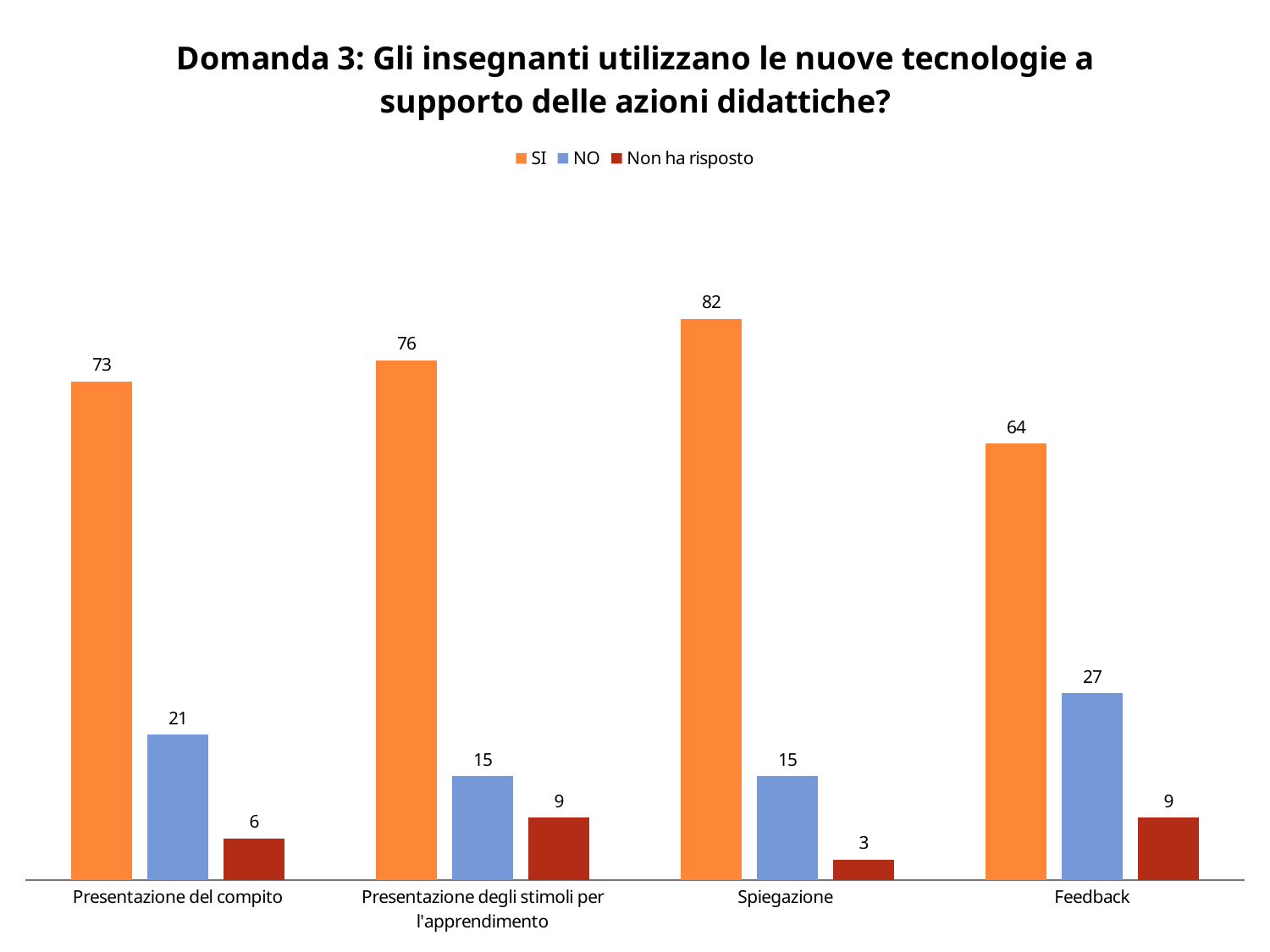
Which colour represents the NO series? Blue What is the NO value for Feedback? 27 Which category has the highest SI value? Spiegazione What is the SI value for Spiegazione? 82 How many categories are shown on the x axis? 4 What is the total of the three values for Feedback? 100 How many series does the legend list? 3 What is the Non ha risposto value for Presentazione del compito? 6 Which category has the lowest Non ha risposto value? Spiegazione Which is larger, the NO value for Presentazione del compito or the NO value for Spiegazione? Presentazione del compito What kind of chart is shown on the slide? Bar chart What is the difference between the SI values for Spiegazione and Feedback? 18